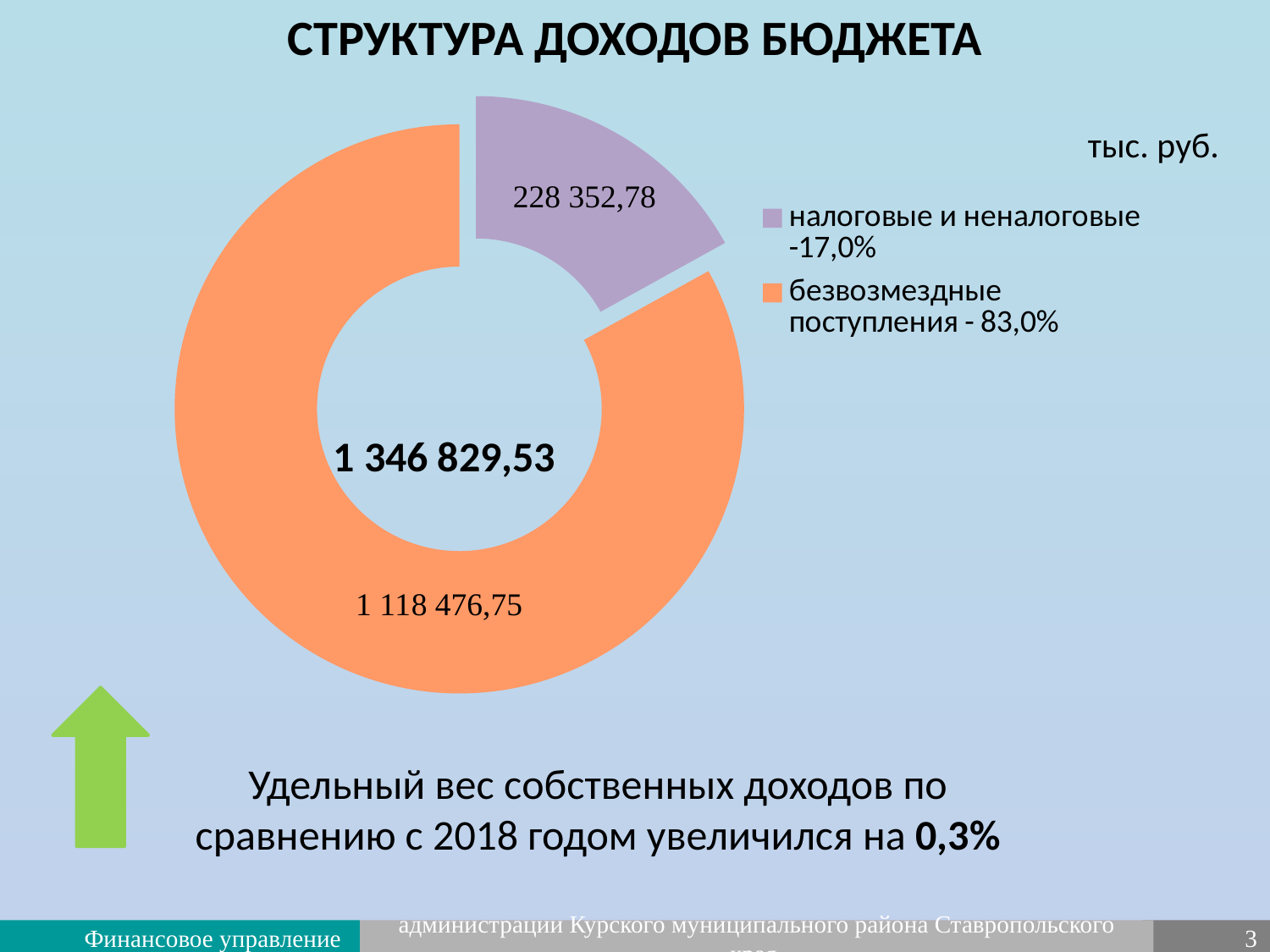
What is the title of the chart? СТРУКТУРА ДОХОДОВ БЮДЖЕТА How many categories does the chart show? 2 What is the value for безвозмездные поступления? 1 118 476,75 What share of the chart do налоговые и неналоговые make up? 17,0% What is the difference between the value for безвозмездные поступления and the value for налоговые и неналоговые? 890 123,97 Which is larger: налоговые и неналоговые or безвозмездные поступления? безвозмездные поступления What share of the chart do безвозмездные поступления make up? 83,0% What is the total of the two slices shown in the centre of the chart? 1 346 829,53 Which category has the largest share of the chart? безвозмездные поступления What kind of chart is shown on the slide? Doughnut (pie) chart What is the value for налоговые и неналоговые? 228 352,78 Which category has the smallest share of the chart? налоговые и неналоговые